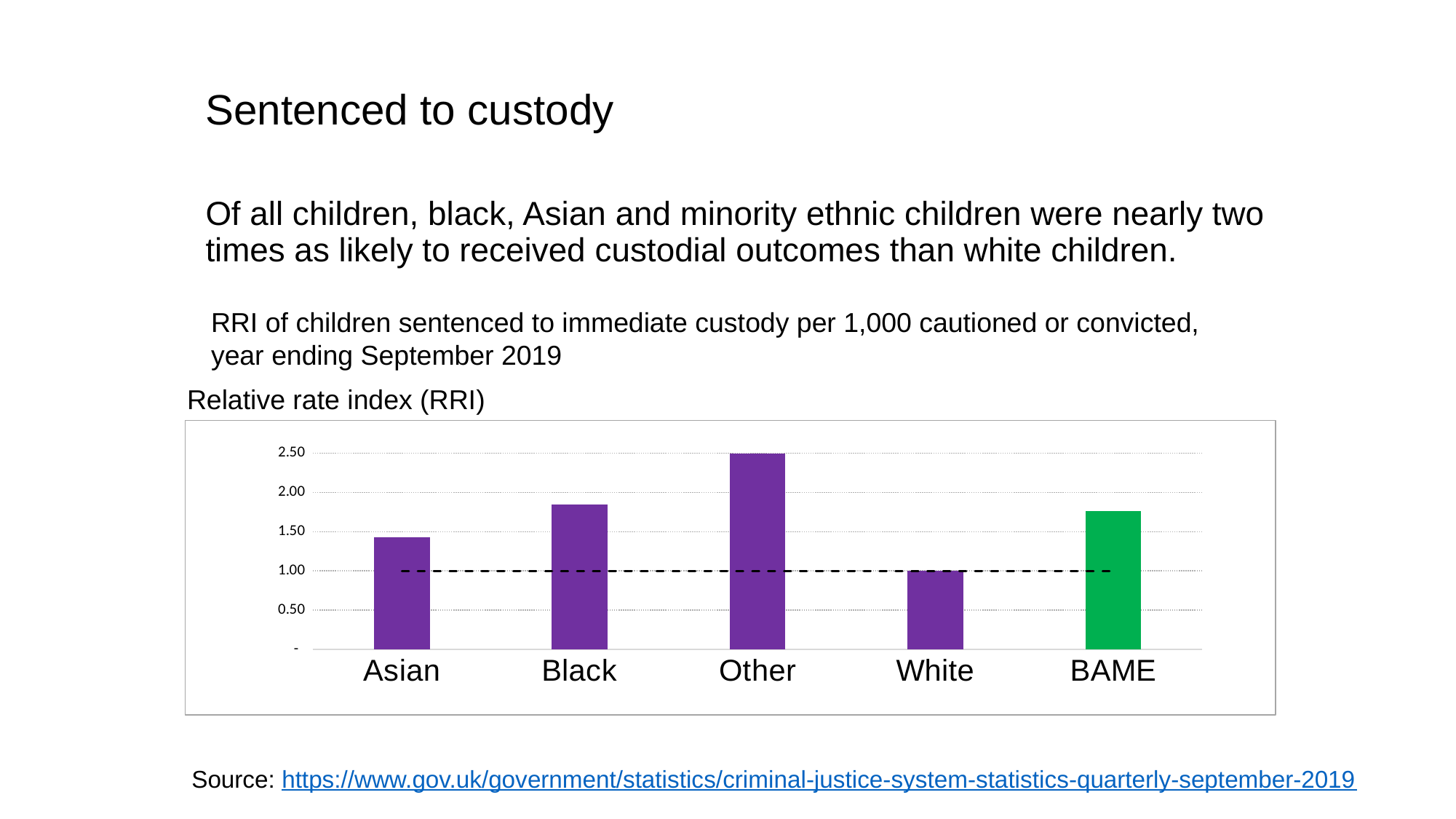
What kind of chart is shown on the slide? bar chart Is the value for BAME greater or less than 2.00? less What is the relative rate index value for White in the chart? 1.00 Is the value for Black greater or less than 1.50? greater Is the value for Other greater or less than 2.00? greater How many categories are shown on the x axis of the chart? 5 Which category has the lowest relative rate index in the chart? White What colour is the BAME bar in the chart? green Which has the larger relative rate index, Other or BAME? Other Which has the larger relative rate index, Black or Asian? Black Which category has the highest relative rate index in the chart? Other